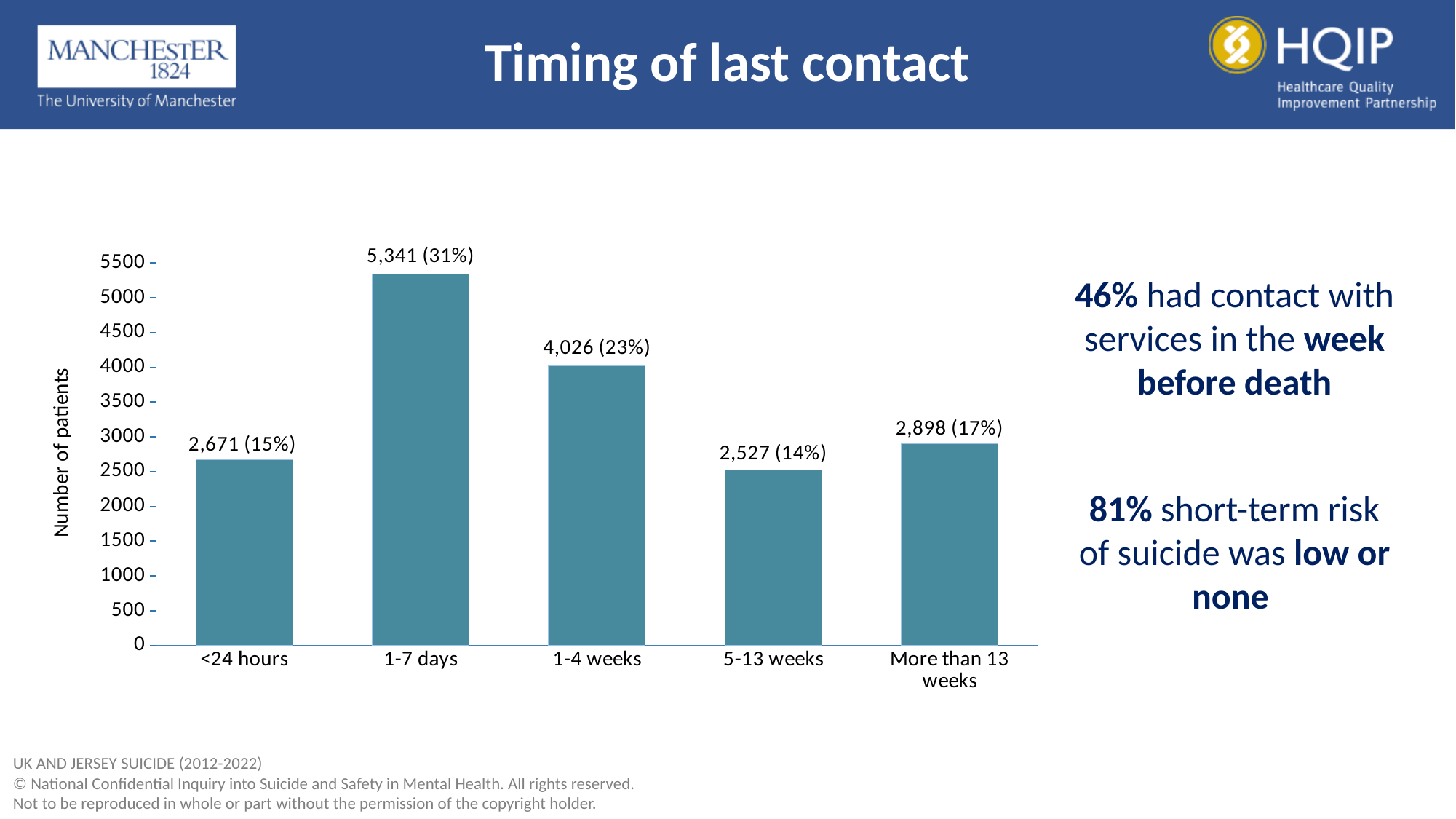
Which category has the lowest number of patients? 5-13 weeks What percentage is shown for the 'More than 13 weeks' category? 17% What is the number of patients whose last contact was 1-7 days before death? 5,341 (31%) What is the difference in number of patients between the 1-7 days and 1-4 weeks categories? 1,315 Which category has the highest number of patients? 1-7 days What is the label of the y axis? Number of patients Is the value for 1-4 weeks greater or less than 4000? greater What kind of chart is shown on the slide? Bar chart What is the number of patients whose last contact was 5-13 weeks before death? 2,527 (14%) Which has more patients: <24 hours or More than 13 weeks? More than 13 weeks What is the number of patients whose last contact was <24 hours before death? 2,671 (15%) How many categories are shown on the x axis? 5